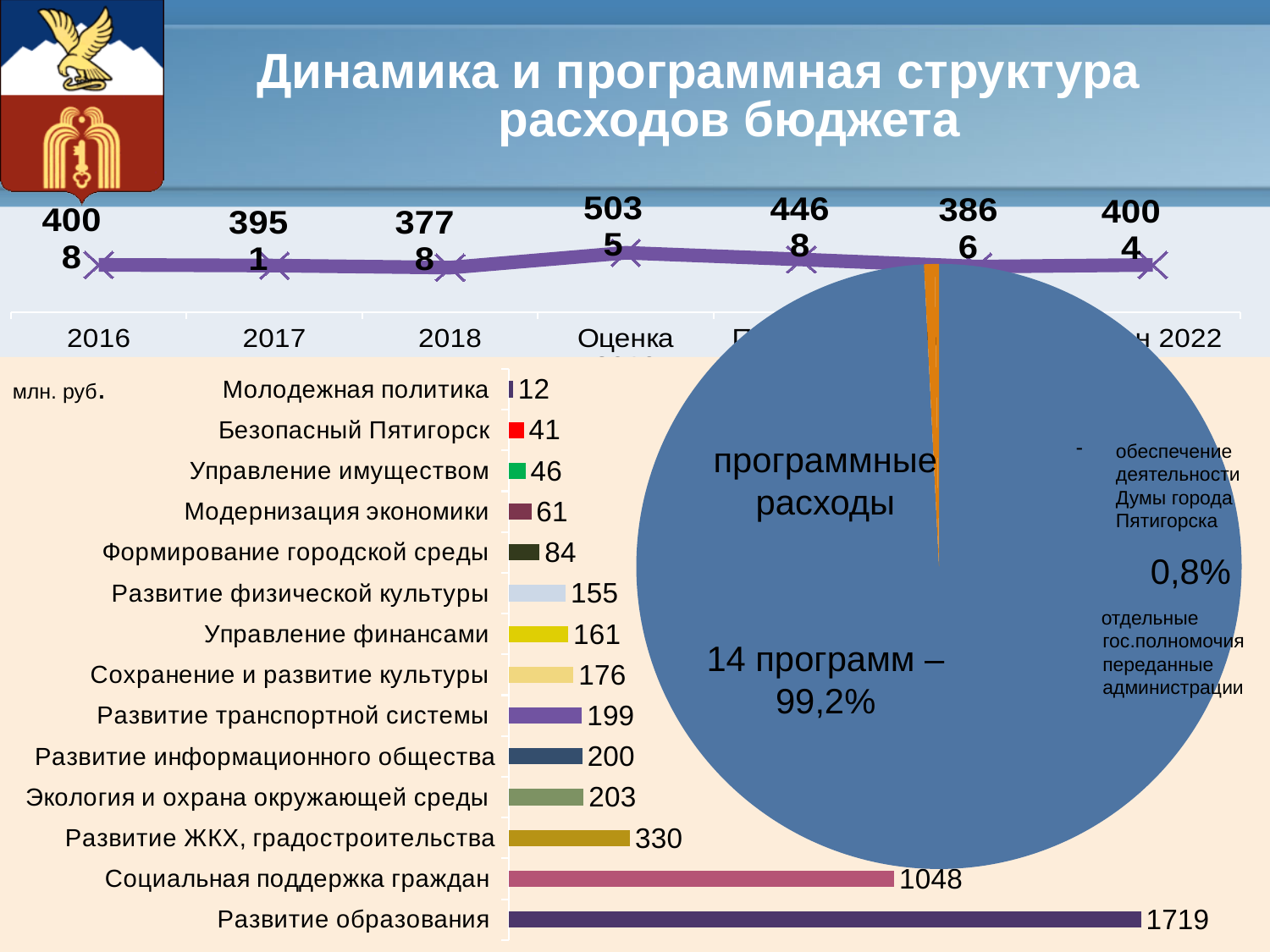
In the line chart at the top, what is the value for 2016? 4008 In the bar chart, which category has the lowest value? Молодежная политика In the bar chart, which category has the highest value? Развитие образования In the line chart at the top, what is the highest value plotted? 5035 In the bar chart, what is the value for Развитие ЖКХ, градостроительства? 330 In the pie chart, what share do программные расходы (14 программ) have? 99,2% In the bar chart, which is larger: Управление финансами or Развитие физической культуры? Управление финансами In the line chart at the top, what is the value for 2018? 3778 How many categories does the bar chart show? 14 In the bar chart, what is the value for Социальная поддержка граждан? 1048 In the bar chart, what is the difference between Развитие образования and Социальная поддержка граждан? 671 In the bar chart, what is the value for Развитие образования? 1719